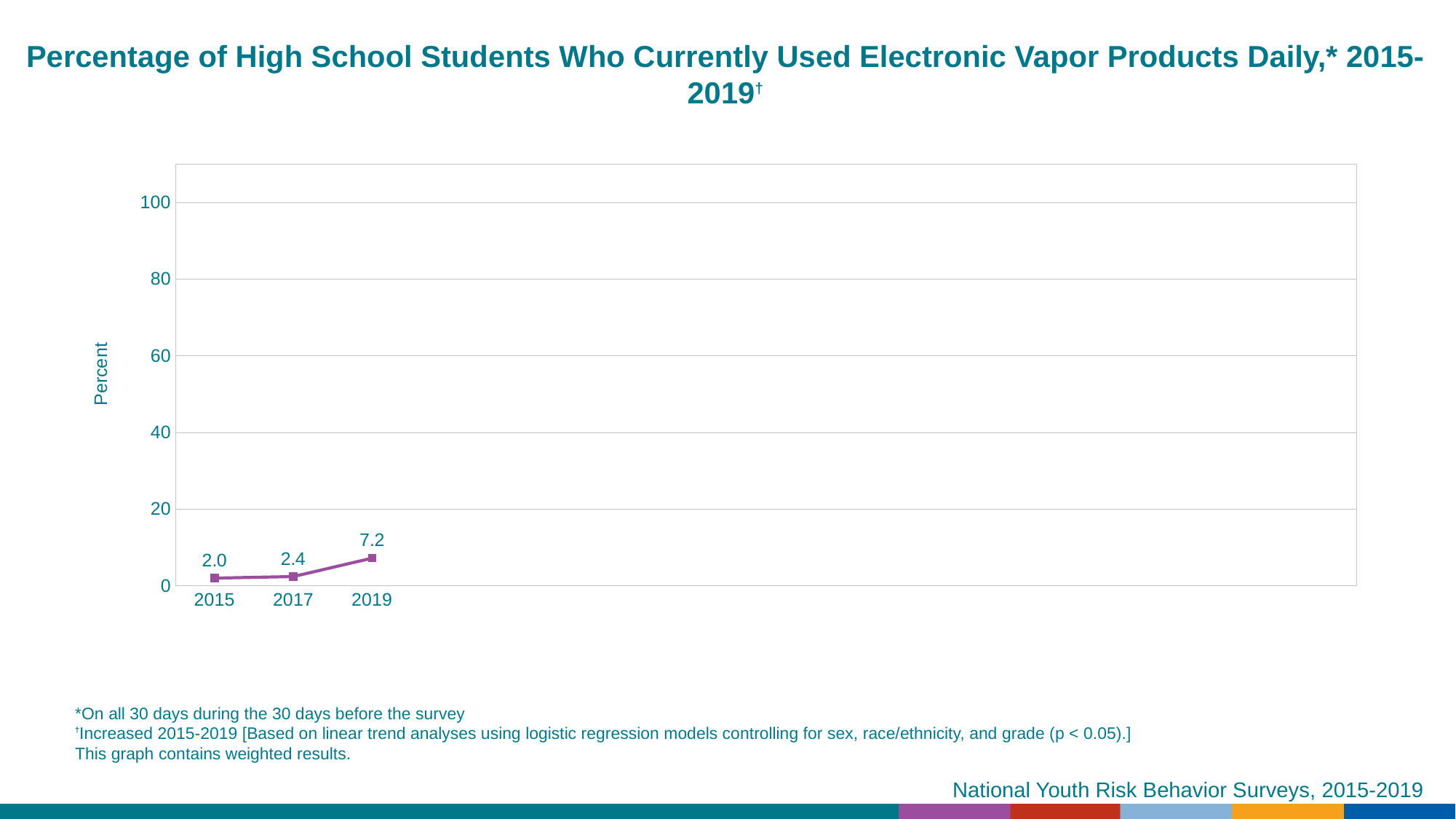
What percentage of high school students currently used electronic vapor products daily in 2015? 2.0 By how many percentage points did daily electronic vapor product use increase from 2015 to 2019? 5.2 How many years are plotted on the chart? 3 Which year has the highest percentage of students who currently used electronic vapor products daily? 2019 What is the difference between the 2019 and 2017 values? 4.8 Do the values rise or fall from 2015 to 2019? rise Is the value for 2019 greater or less than 20? less Which year has a larger value, 2017 or 2019? 2019 What kind of chart is shown on the slide? line chart Which year has the lowest percentage of students who currently used electronic vapor products daily? 2015 What percentage of high school students currently used electronic vapor products daily in 2017? 2.4 What percentage of high school students currently used electronic vapor products daily in 2019? 7.2